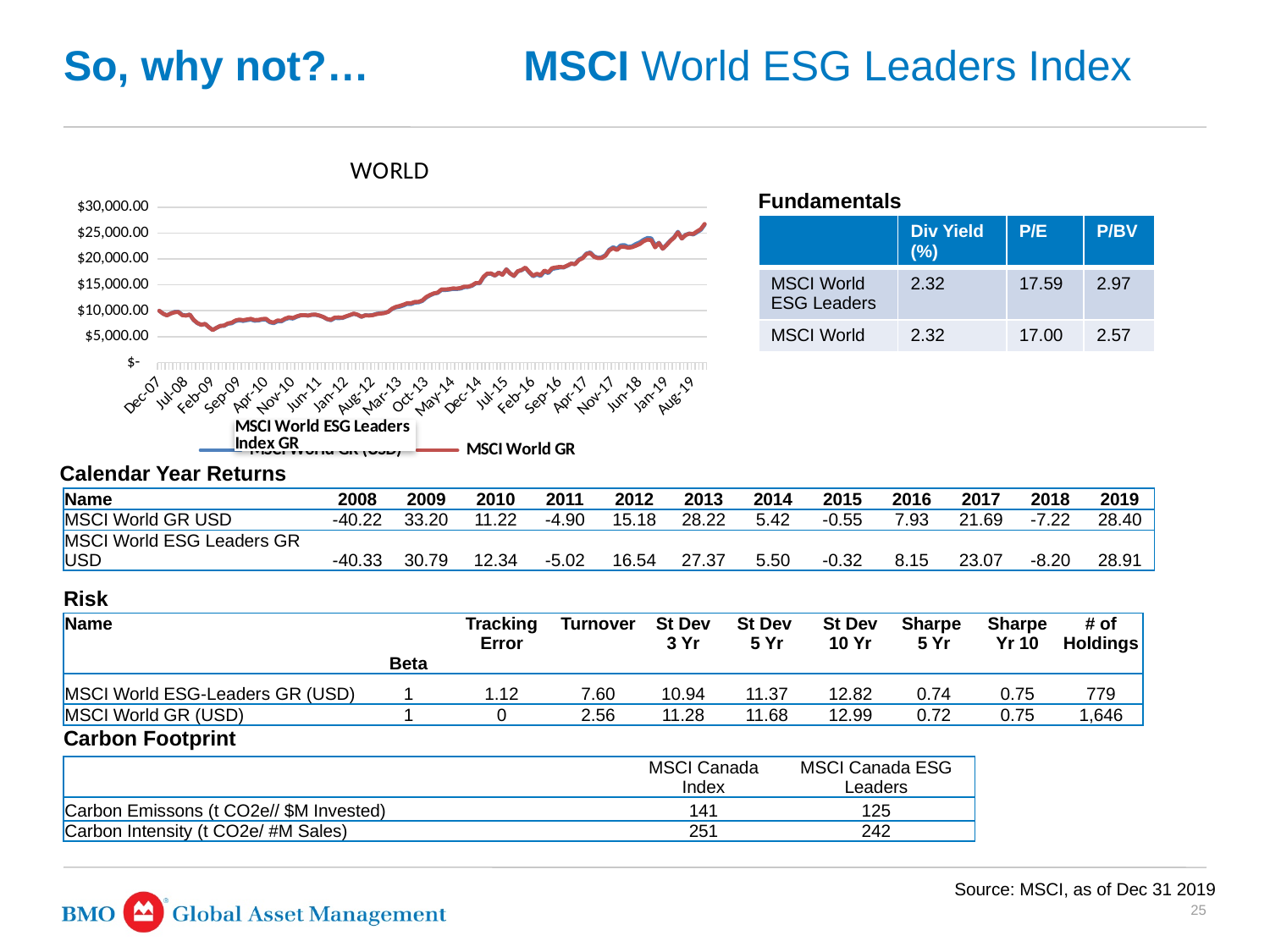
In the "WORLD" chart, do the index values overall rise or fall from Dec-07 to Aug-19? rise In the "WORLD" chart, what colour is the MSCI World GR line? red In the "WORLD" chart, is the value of MSCI World GR at Jan-12 greater or less than $15,000.00? less In the "WORLD" chart, is the value of MSCI World GR at Aug-19 greater or less than $20,000.00? greater In the "WORLD" chart, is the value of MSCI World GR around Feb-09 greater or less than $10,000.00? less In the "WORLD" chart, do the values fall or rise between Dec-07 and Feb-09? fall What kind of chart is the "WORLD" chart on the slide? line chart What is the title of the chart on the slide? WORLD How many series does the legend of the "WORLD" chart list? 2